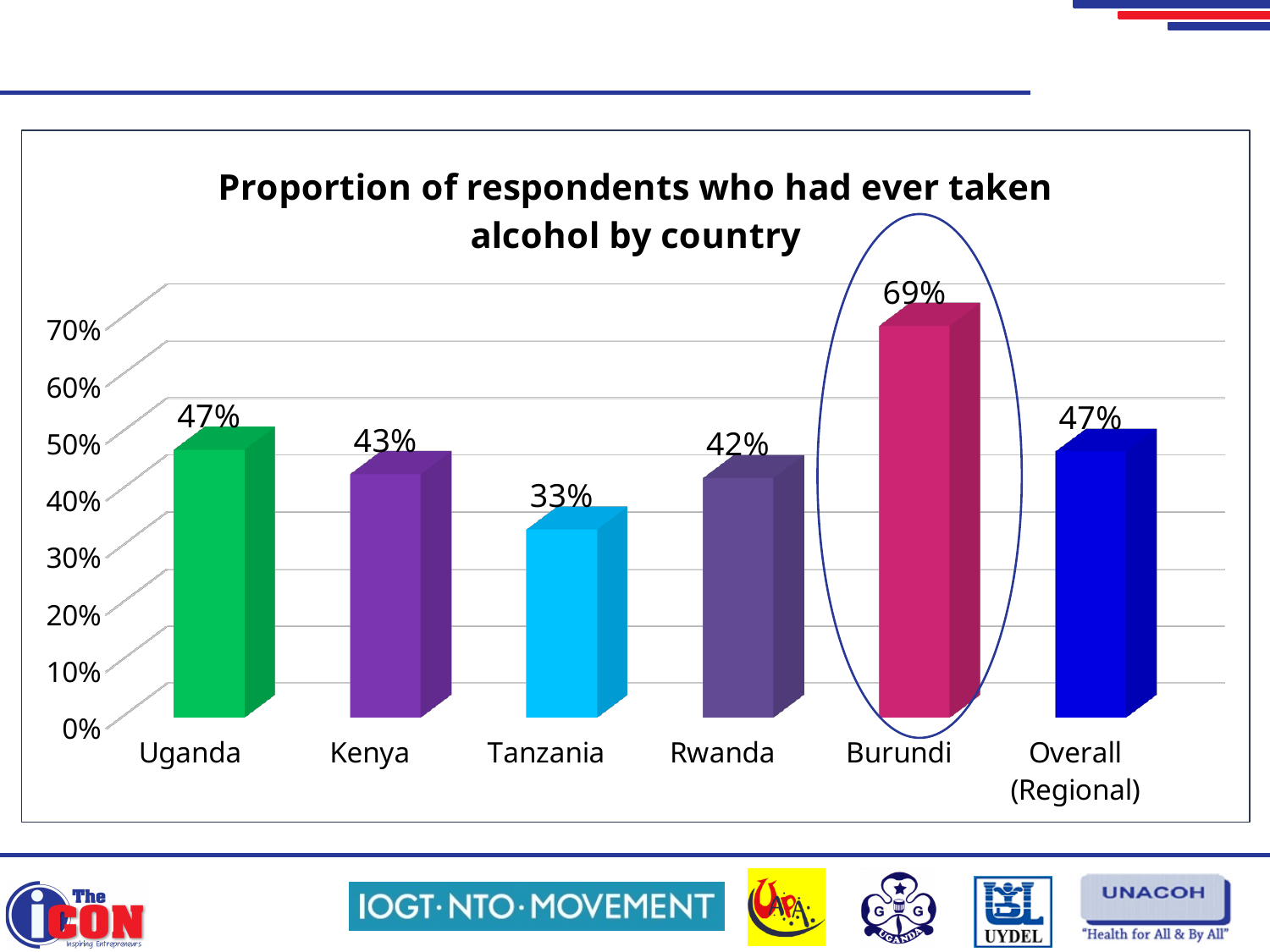
What kind of chart is shown on the slide? bar chart What is the title of the chart? Proportion of respondents who had ever taken alcohol by country What is the value for Burundi? 69% Which country has the highest proportion of respondents who had ever taken alcohol? Burundi Which country has the lowest proportion of respondents who had ever taken alcohol? Tanzania Which is larger, the value for Uganda or the value for Tanzania? Uganda What is the difference between the values for Kenya and Rwanda? 1% How many categories are shown on the x axis? 6 What is the difference between the values for Burundi and Tanzania? 36% Is the value for Burundi greater or less than 60%? greater What is the value for Overall (Regional)? 47% What is the value for Tanzania? 33%